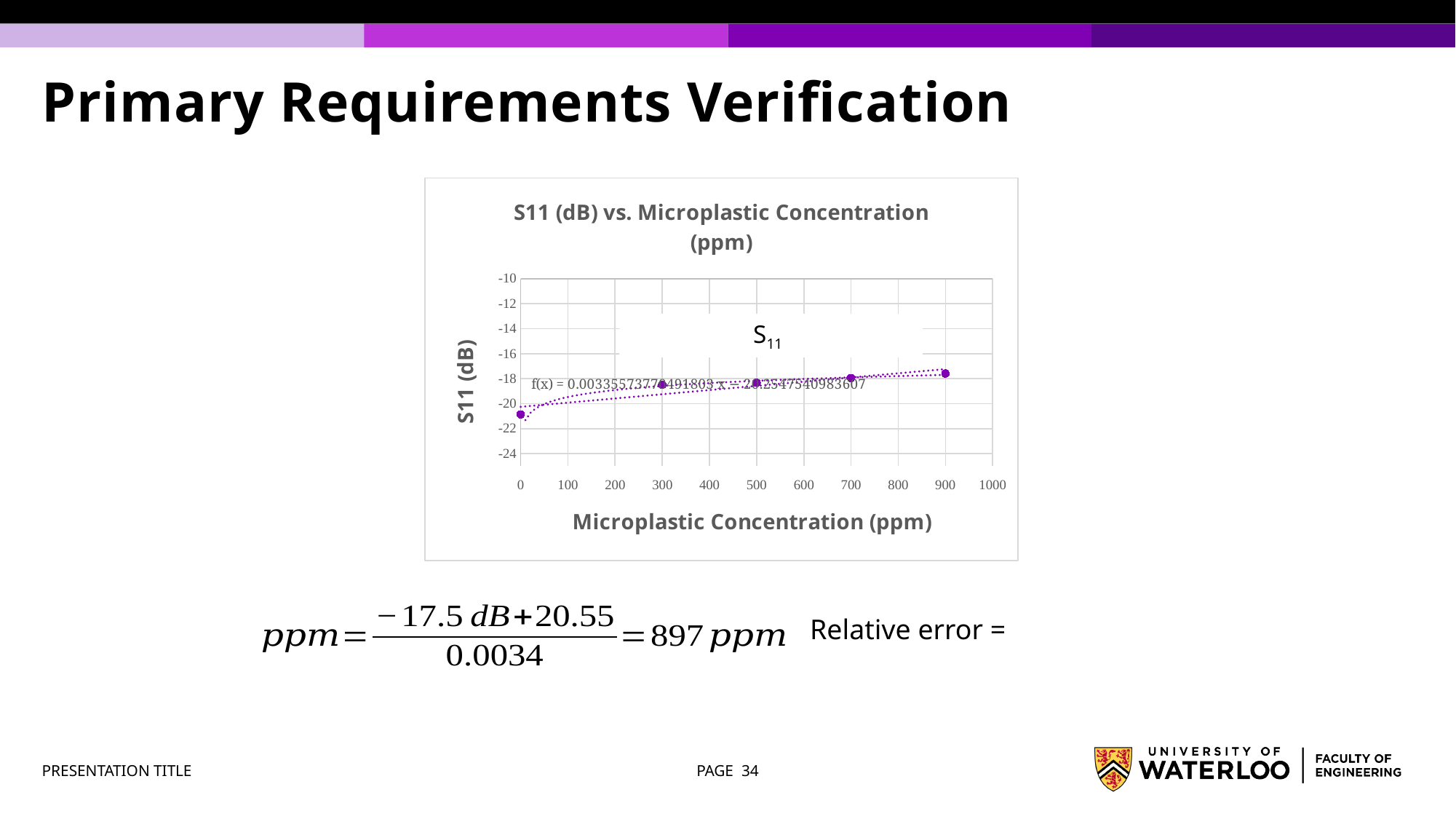
Is the S11 value at 300 ppm greater or less than -20? greater Do the S11 values rise or fall as microplastic concentration increases? rise Is the S11 value at 500 ppm greater or less than -16? less What is the title of the chart? S11 (dB) vs. Microplastic Concentration (ppm) Is the S11 value at 0 ppm greater or less than -20? less Which has the larger S11 value: the point at 0 ppm or the point at 900 ppm? 900 ppm At which microplastic concentration is the S11 value highest? 900 What type of chart is shown on the slide? scatter chart At which microplastic concentration is the S11 value lowest? 0 How many data points are plotted in the chart? 5 What is the label of the x axis of the chart? Microplastic Concentration (ppm)